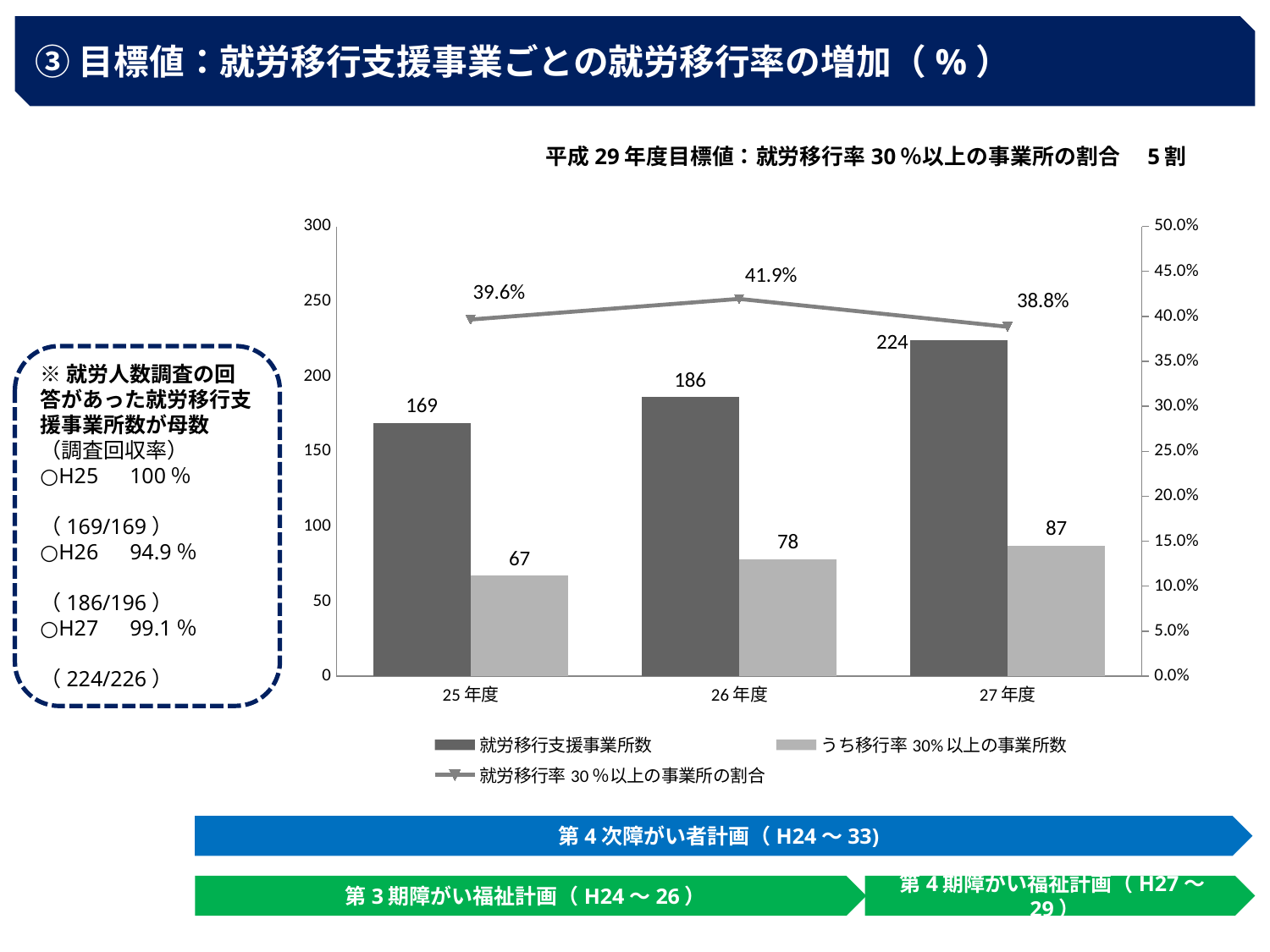
How many years (categories) are shown on the x axis? 3 Does 就労移行支援事業所数 rise or fall from 25年度 to 27年度? rise How many series does the legend list? 3 In which year is 就労移行支援事業所数 lowest? 25年度 What is the value of 就労移行支援事業所数 for 26年度? 186 What is the value of うち移行率30%以上の事業所数 for 27年度? 87 What kind of chart is used for the 就労移行率30%以上の事業所の割合 series? line chart What is the 就労移行率30%以上の事業所の割合 for 25年度? 39.6% What is the difference between 就労移行支援事業所数 and うち移行率30%以上の事業所数 in 27年度? 137 In which year is the 就労移行率30%以上の事業所の割合 highest? 26年度 Which is larger: うち移行率30%以上の事業所数 in 26年度 or in 25年度? 26年度 By how much did 就労移行支援事業所数 increase from 25年度 to 27年度? 55